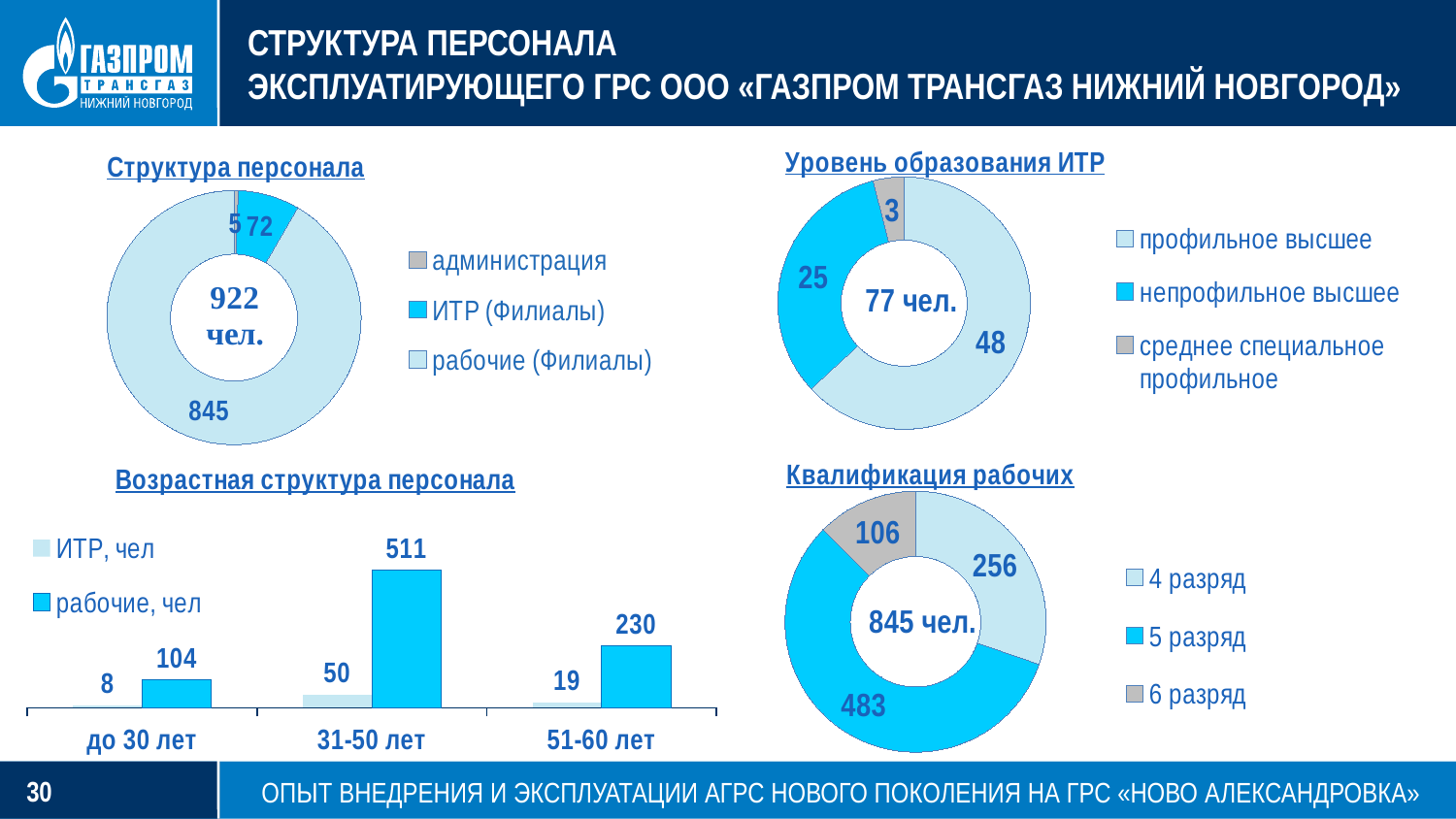
In the 'Структура персонала' chart, what total is shown in the centre of the donut? 922 чел. In the 'Возрастная структура персонала' chart, what is the difference between рабочие, чел and ИТР, чел in the 51-60 лет group? 211 In the 'Уровень образования ИТР' chart, what is the difference between профильное высшее and среднее специальное профильное? 45 In the 'Квалификация рабочих' chart, is the value for 4 разряд larger or smaller than the value for 6 разряд? larger In the 'Структура персонала' chart, which category has the smallest value? администрация In the 'Уровень образования ИТР' chart, how many categories does the legend list? 3 In the 'Уровень образования ИТР' chart, what is the value for непрофильное высшее? 25 In the 'Структура персонала' chart, what is the value for рабочие (Филиалы)? 845 In the 'Возрастная структура персонала' chart, which age group has the highest value for ИТР, чел? 31-50 лет What kind of chart is 'Возрастная структура персонала'? bar chart In the 'Возрастная структура персонала' chart, what is the value for рабочие, чел in the 31-50 лет group? 511 In the 'Квалификация рабочих' chart, which category has the largest value? 5 разряд